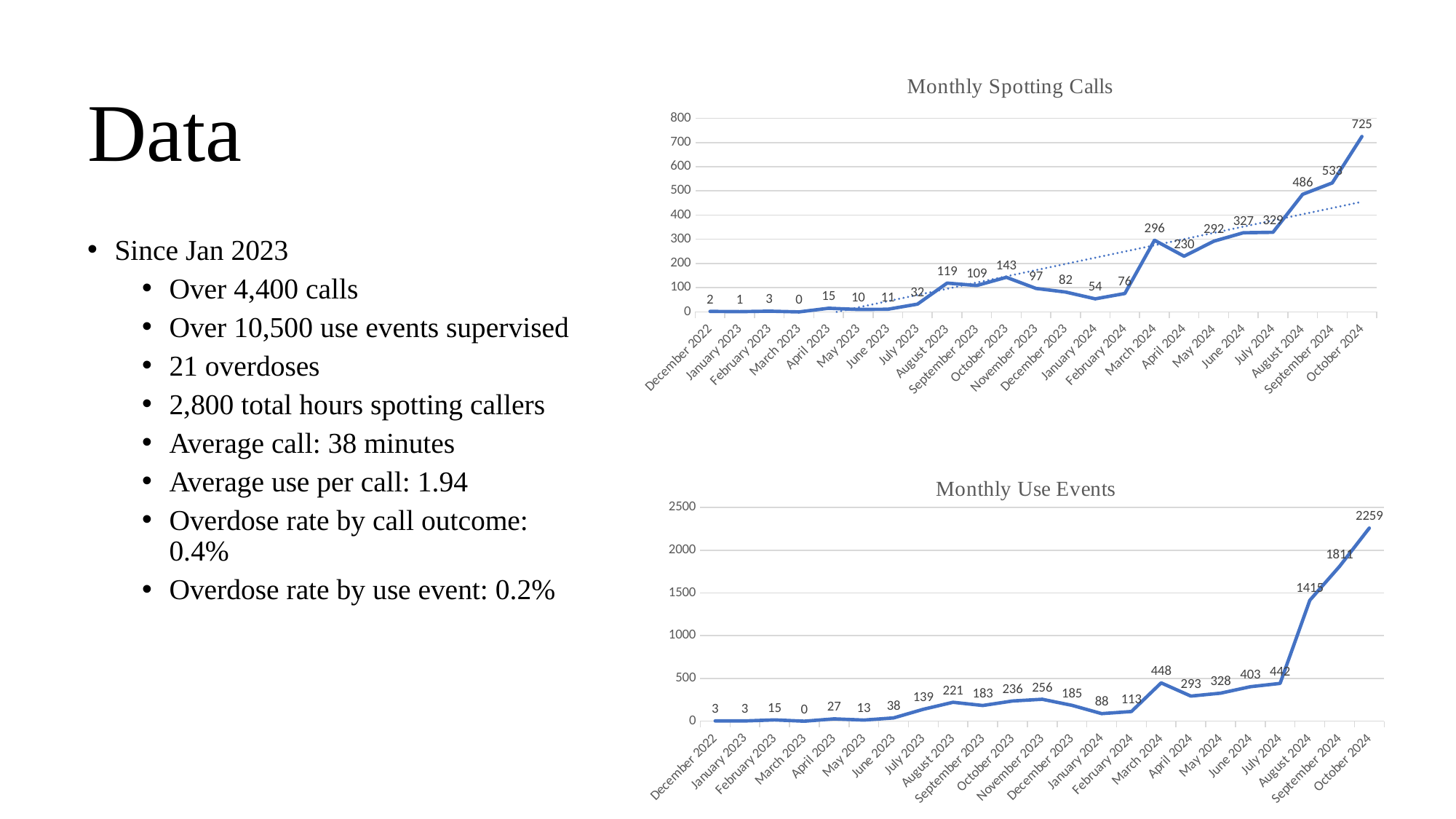
How many months are plotted in the Monthly Use Events chart? 23 In the Monthly Spotting Calls chart, what is the value for March 2024? 296 In the Monthly Use Events chart, do the values generally rise or fall from December 2022 to October 2024? Rise In the Monthly Spotting Calls chart, which is larger, the value for March 2024 or the value for April 2024? March 2024 In the Monthly Use Events chart, which month has the lowest value? March 2023 What kind of chart is the Monthly Spotting Calls chart? Line chart In the Monthly Spotting Calls chart, which month has the highest value? October 2024 In the Monthly Use Events chart, what is the difference between the values for August 2024 and July 2024? 973 In the Monthly Spotting Calls chart, what is the difference between the values for October 2024 and September 2024? 192 In the Monthly Use Events chart, what is the value for September 2024? 1811 In the Monthly Use Events chart, what is the value for November 2023? 256 In the Monthly Spotting Calls chart, what is the value for October 2024? 725